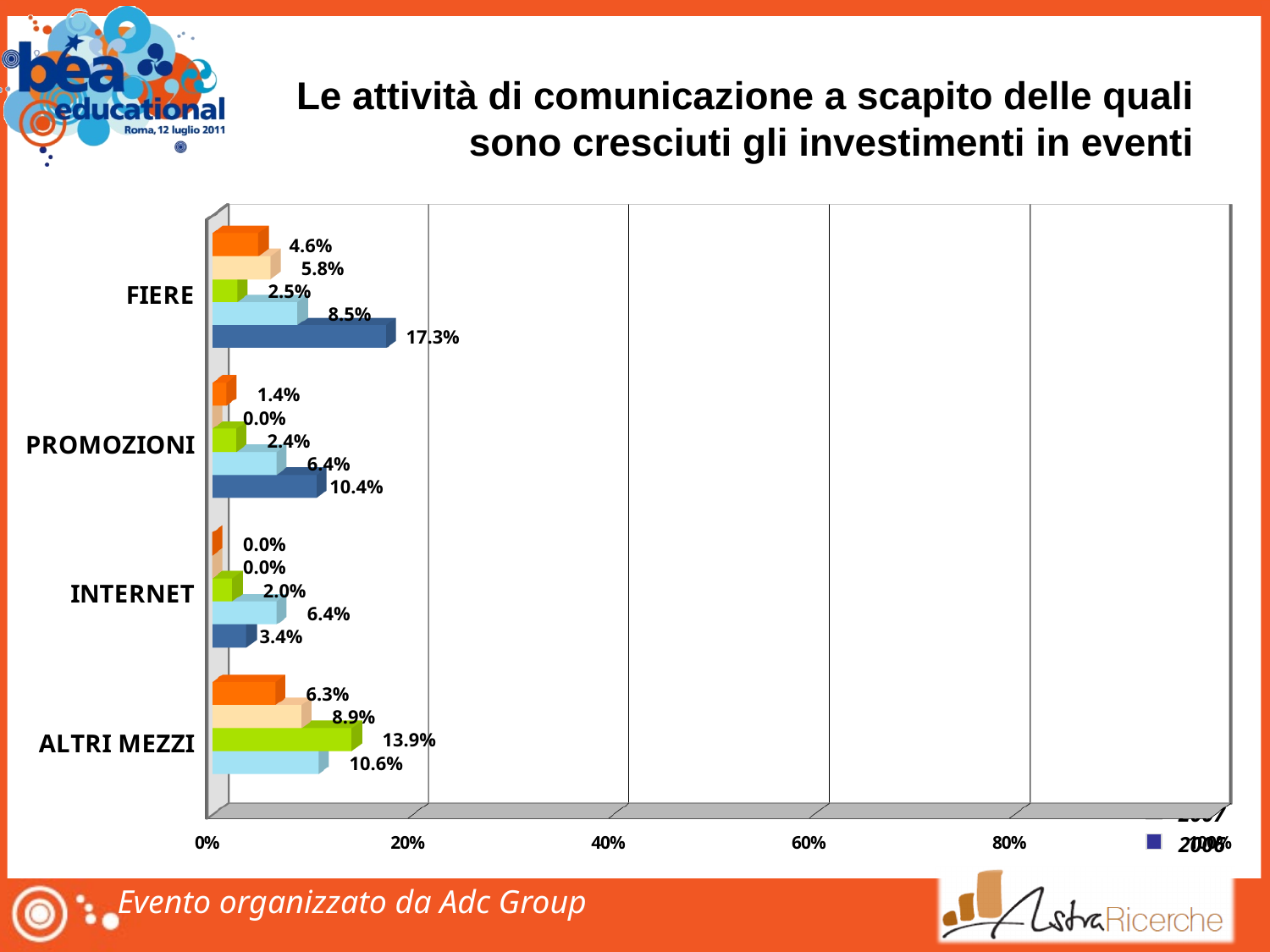
Is the largest value on the chart greater or less than 20%? less How many bars are drawn for the ALTRI MEZZI category? 4 What is the difference between the two largest values labelled for FIERE (17.3% and 8.5%)? 8.8% What is the largest value labelled for PROMOZIONI? 10.4% What is the interval between the tick marks on the horizontal axis? 20% How many categories are listed on the vertical axis of the chart? 4 What is the smallest value labelled for INTERNET? 0.0% Which is larger: the largest value for FIERE or the largest value for ALTRI MEZZI? FIERE What kind of chart is shown on the slide? Bar chart What is the largest value labelled for ALTRI MEZZI? 13.9% Which category contains the bar with the highest value on the chart? FIERE What is the highest value labelled anywhere on the chart? 17.3%